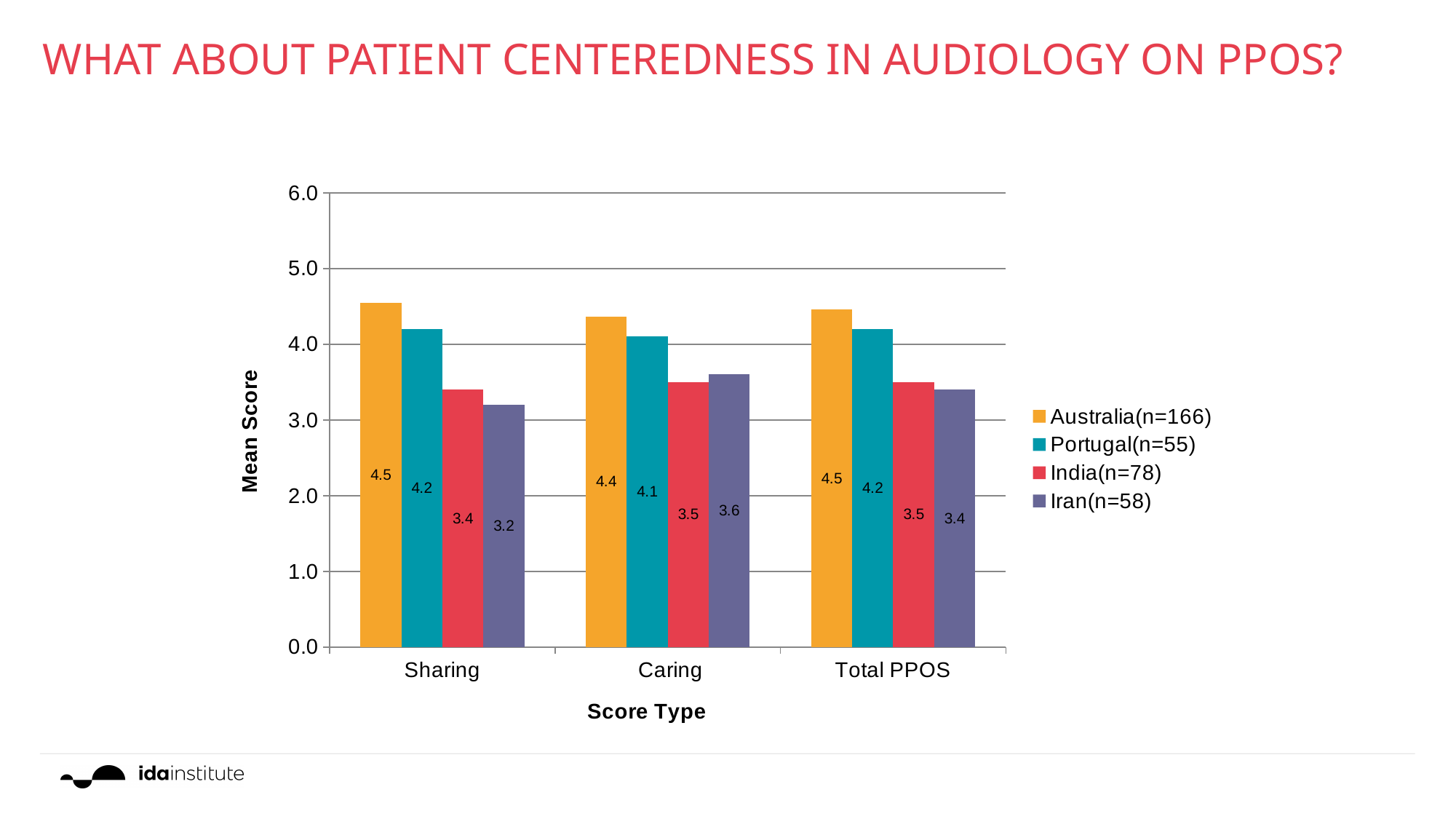
How many series does the legend list? 4 What is the mean score for Iran(n=58) on Caring? 3.6 Which is larger on Caring: the mean score for India(n=78) or Iran(n=58)? Iran(n=58) What is the label of the y axis? Mean Score Which country has the lowest mean score on Sharing? Iran(n=58) What kind of chart is shown on the slide? bar chart Is the mean score for Portugal(n=55) on Caring greater or less than 4.0? greater What is the mean score for India(n=78) on Total PPOS? 3.5 What is the mean score for Australia(n=166) on Sharing? 4.5 Which country has the highest mean score on Sharing? Australia(n=166) How many score types are shown on the x axis? 3 What is the difference between the Australia(n=166) and Iran(n=58) mean scores on Sharing? 1.3